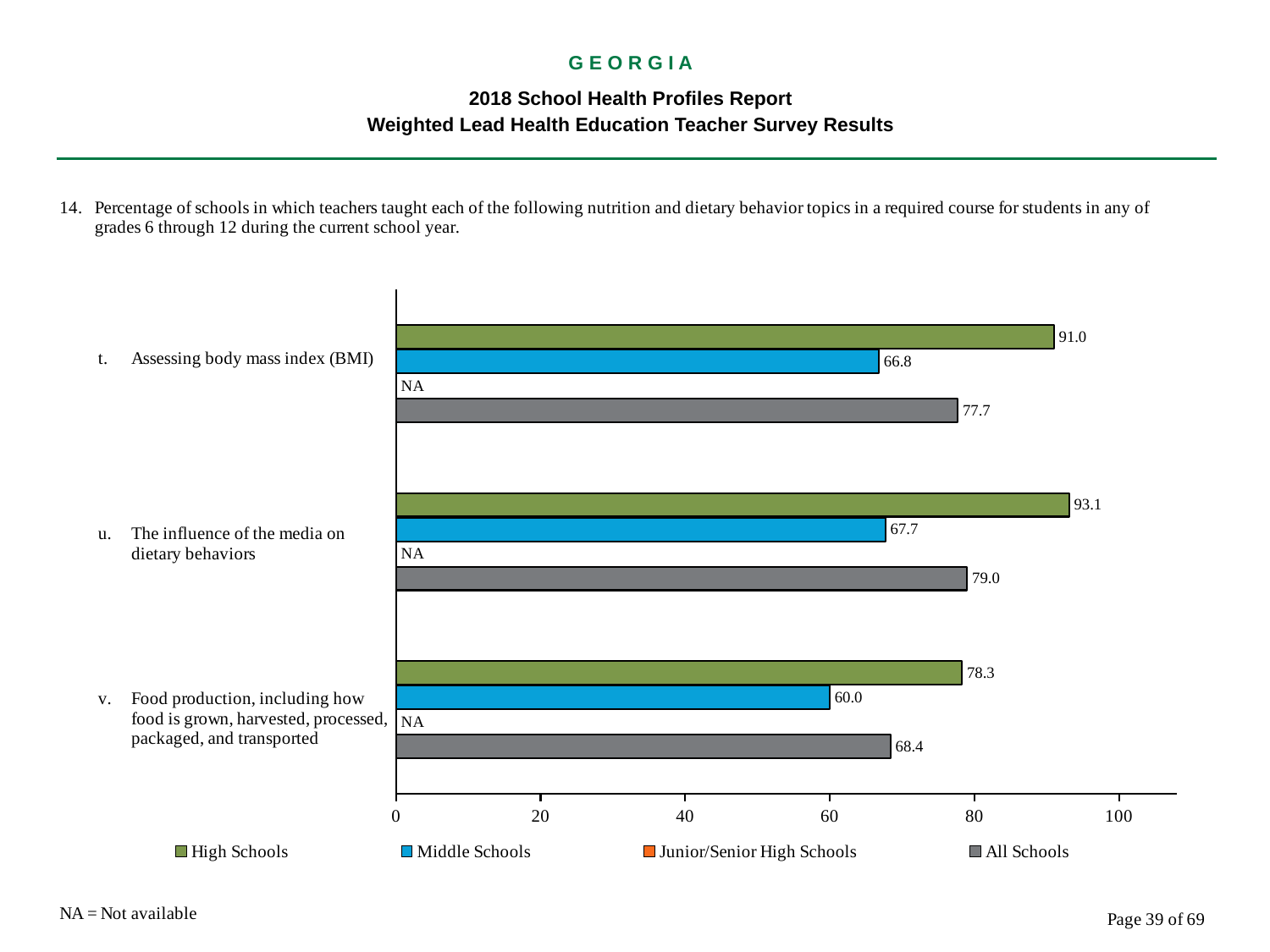
Which topic has the lowest Middle Schools value? Food production, including how food is grown, harvested, processed, packaged, and transported What is the difference between the High Schools and Middle Schools values for 'Assessing body mass index (BMI)'? 24.2 What is the value for Middle Schools for 'The influence of the media on dietary behaviors'? 67.7 What is the value for All Schools for 'Food production, including how food is grown, harvested, processed, packaged, and transported'? 68.4 Which topic has the highest High Schools value? The influence of the media on dietary behaviors What is the value for High Schools for 'Assessing body mass index (BMI)'? 91.0 Which is larger for 'Food production': the High Schools value or the All Schools value? High Schools How many topics (categories) are shown on the chart? 3 How many series does the legend list? 4 What value is shown for Junior/Senior High Schools for 'Assessing body mass index (BMI)'? NA What kind of chart is shown on the slide? bar chart Is the Middle Schools value for 'Food production' greater or less than 80? less